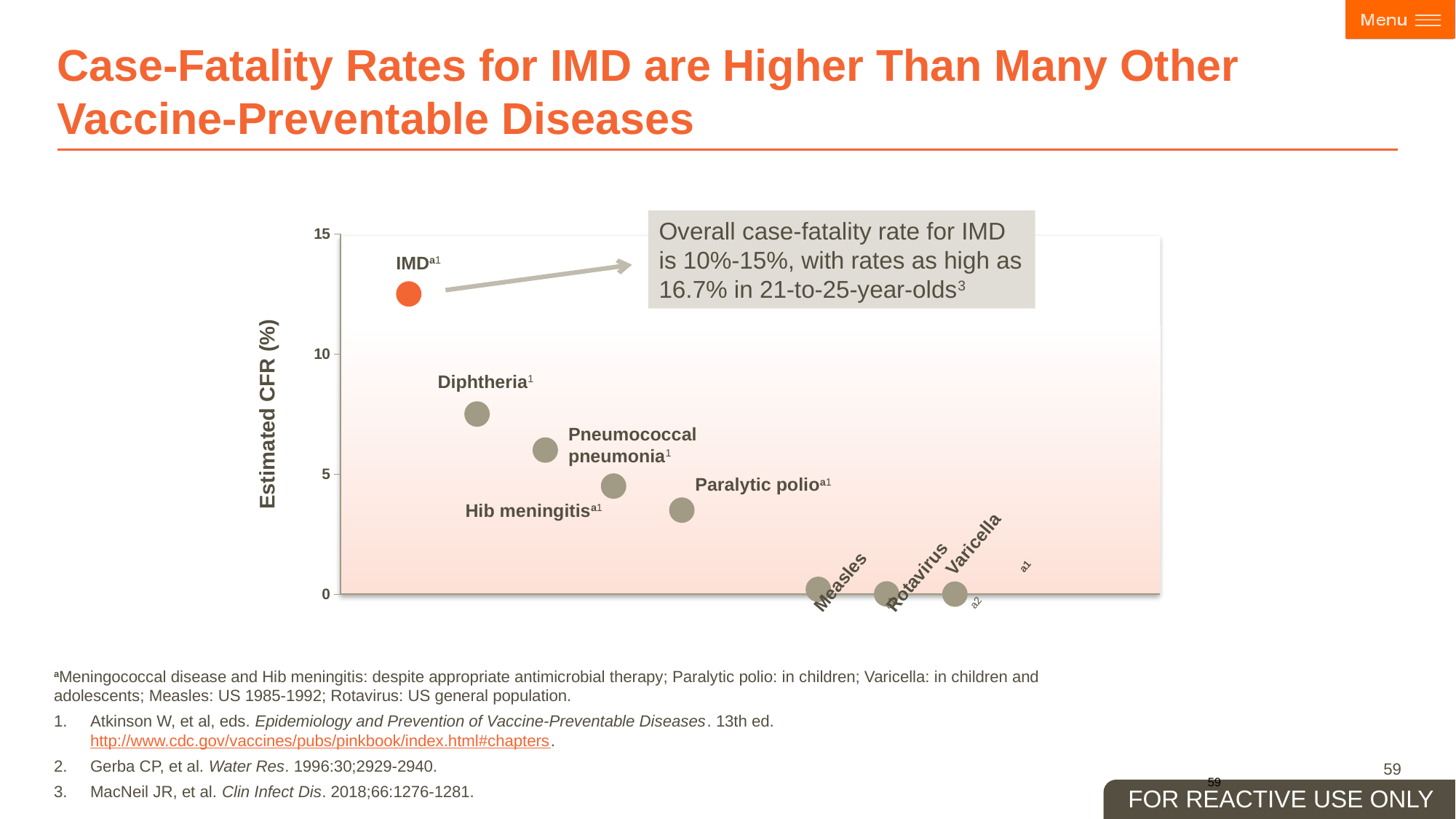
Is the estimated CFR for Hib meningitis greater or less than 10? less Is the estimated CFR for Paralytic polio greater or less than 5? less Is the estimated CFR for Pneumococcal pneumonia greater or less than 5? greater Which disease has the highest estimated CFR (%) on the chart? IMD What kind of chart is shown on the slide? scatter chart Which plotted point is coloured orange rather than grey? IMD What is the label of the vertical axis of the chart? Estimated CFR (%) How many diseases are plotted on the chart? 8 Which has a higher estimated CFR, IMD or Pneumococcal pneumonia? IMD Which has a higher estimated CFR, Diphtheria or Paralytic polio? Diphtheria